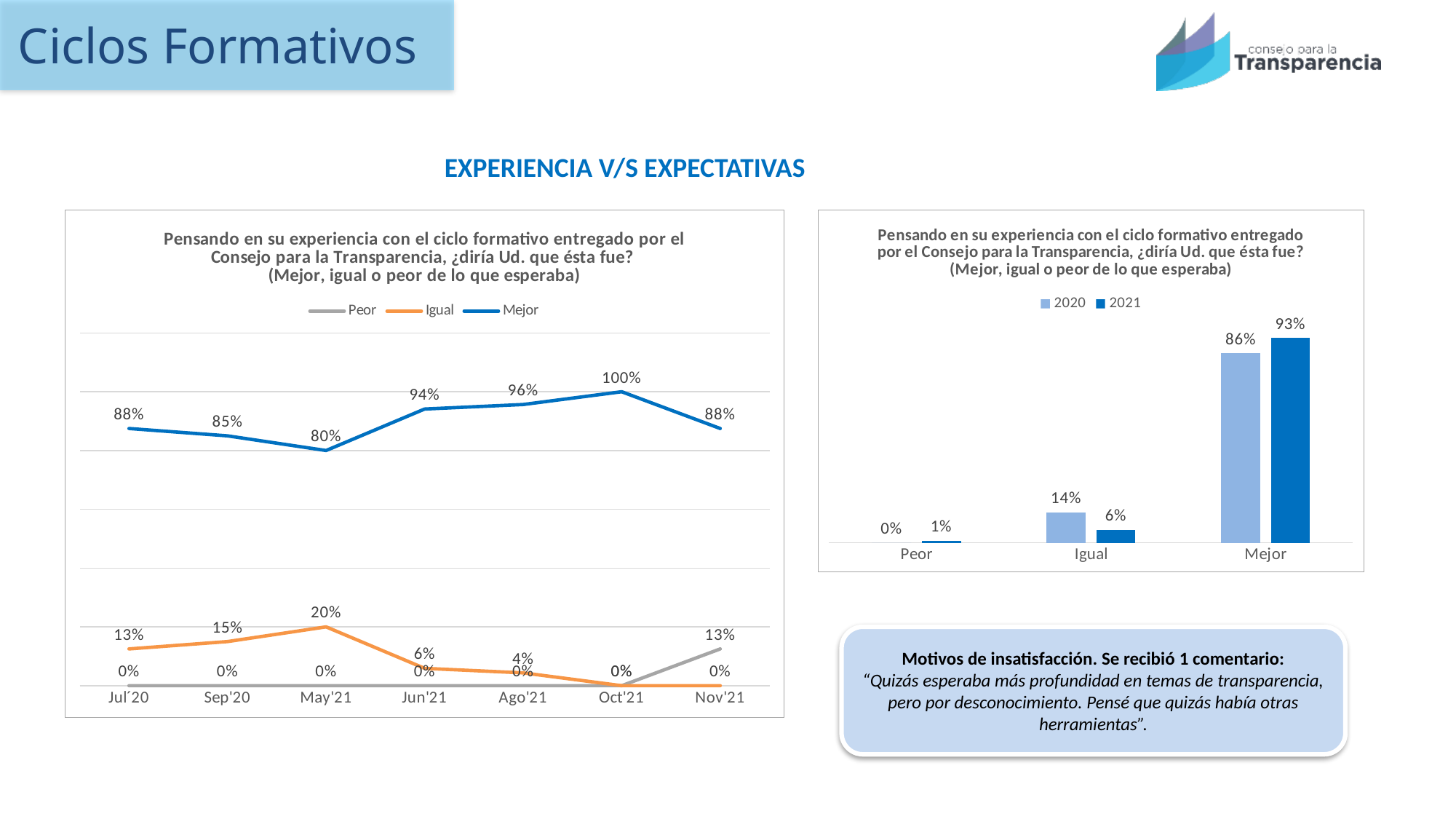
In the line chart on the left, how many series does the legend list? 3 In the line chart on the left, what is the value for Mejor in Oct'21? 100% In the line chart on the left, what is the difference between the Mejor values for Oct'21 and Nov'21? 12% In the line chart on the left, what is the value for Peor in Nov'21? 13% In the line chart on the left, how many months are shown on the x axis? 7 In the bar chart on the right, what is the value for Mejor in 2021? 93% What kind of chart is the chart on the right? Bar chart In the bar chart on the right, what is the difference between the Mejor values for 2021 and 2020? 7% In the bar chart on the right, what is the value for Igual in 2020? 14% In the line chart on the left, what is the value for Igual in May'21? 20% In the bar chart on the right, which is larger for Igual: 2020 or 2021? 2020 In the line chart on the left, in which month is the Mejor series lowest? May'21